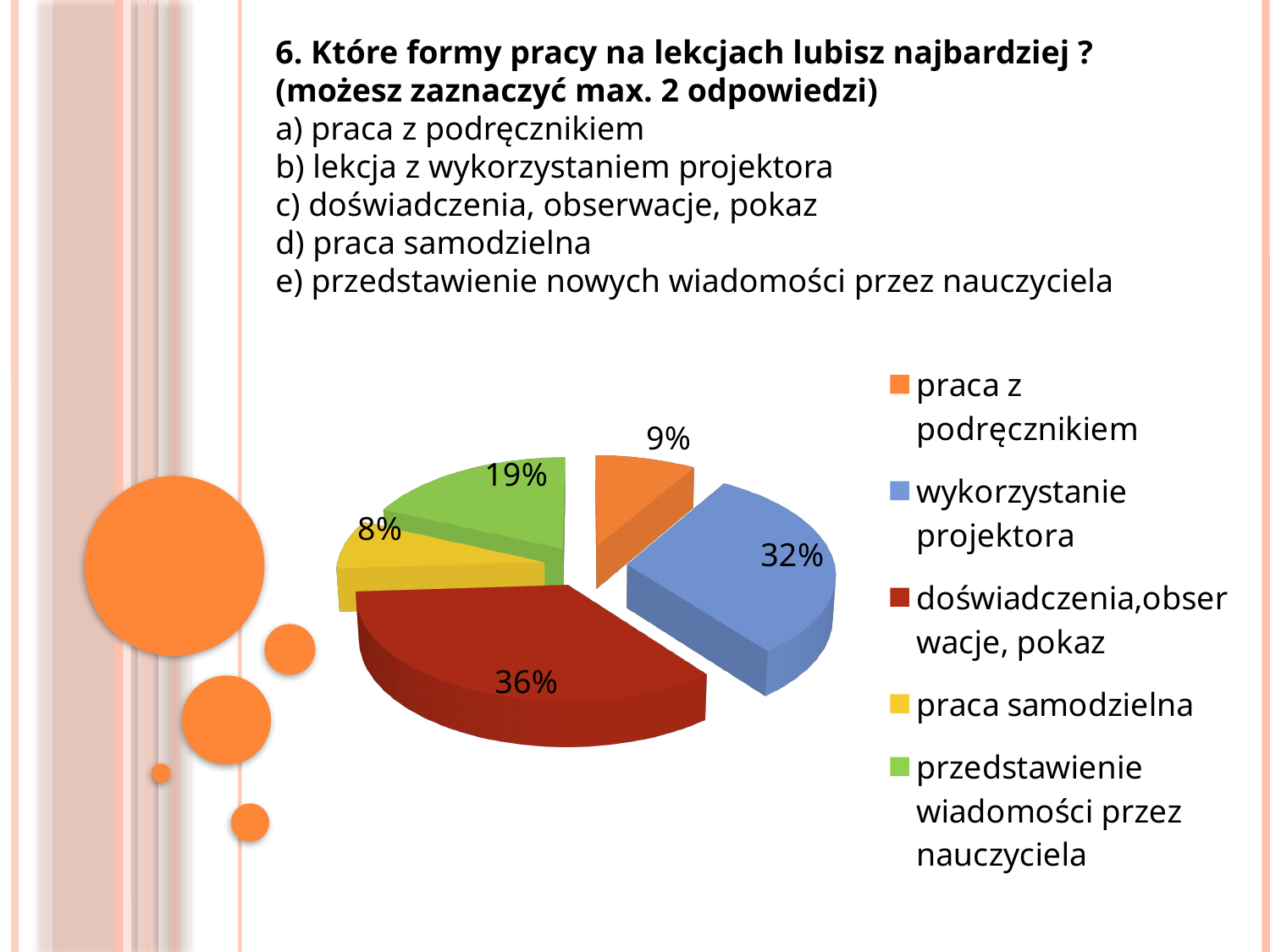
Which is larger: the share for 'przedstawienie wiadomości przez nauczyciela' or the share for 'praca z podręcznikiem'? przedstawienie wiadomości przez nauczyciela What percentage of the pie is 'praca z podręcznikiem'? 9% What percentage of the pie is 'wykorzystanie projektora'? 32% What percentage of the pie is 'przedstawienie wiadomości przez nauczyciela'? 19% Which category has the smallest share of the pie? praca samodzielna What percentage of the pie is 'praca samodzielna'? 8% What kind of chart is shown on the slide? pie chart What is the difference in percentage points between 'doświadczenia,obserwacje, pokaz' and 'wykorzystanie projektora'? 4 Which category has the largest share of the pie? doświadczenia,obserwacje, pokaz How many categories does the legend list? 5 What percentage of the pie is 'doświadczenia,obserwacje, pokaz'? 36% What colour is the slice for 'praca samodzielna'? yellow